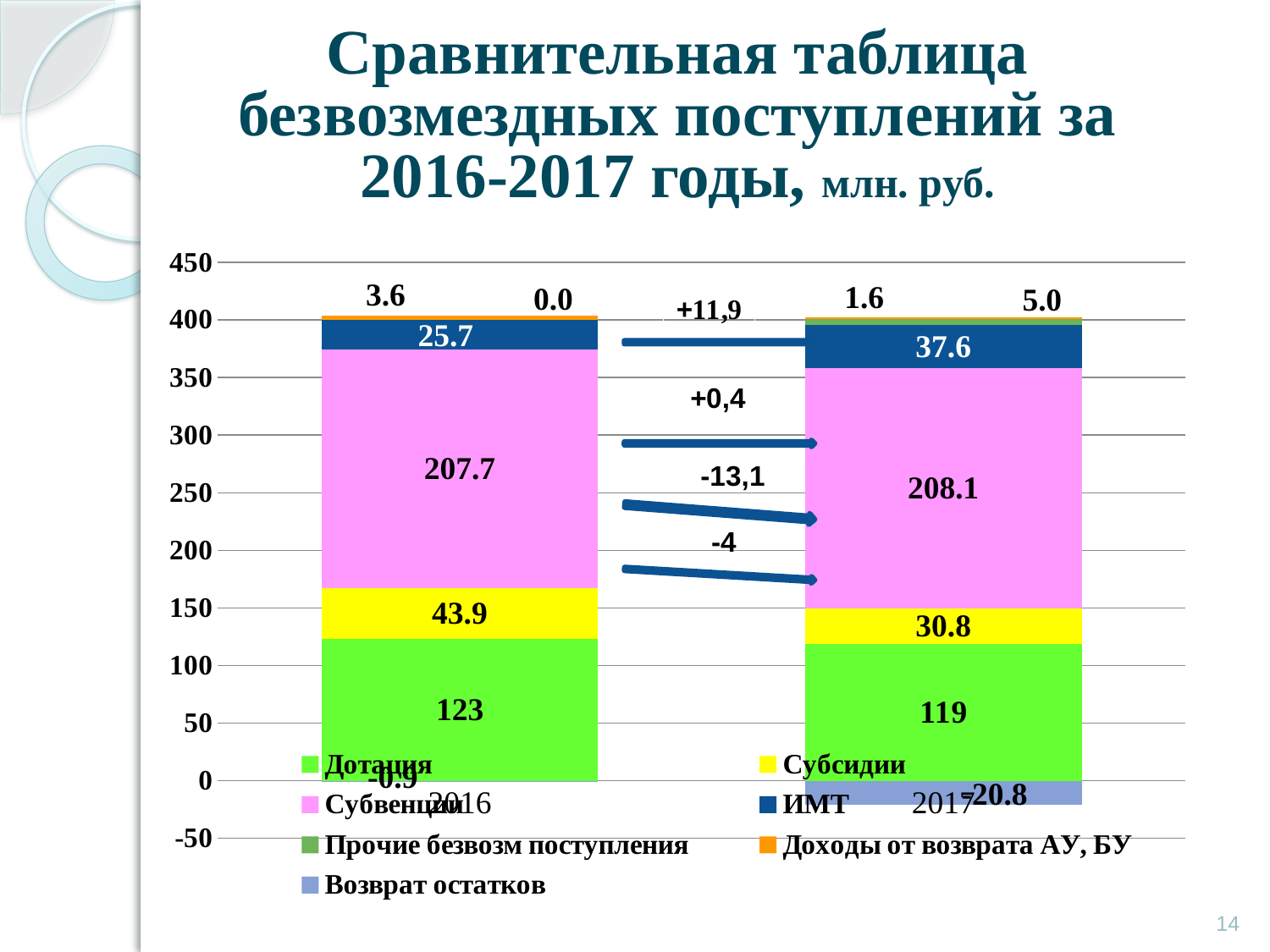
Does the value of Дотация rise or fall from 2016 to 2017? fall What is the value of Дотация for 2016? 123 How many years (categories) are plotted on the x axis? 2 What is the value of Субвенции for 2017? 208.1 What kind of chart is shown on the slide? stacked bar chart In what units are the values on the chart given, according to the title? млн. руб. What is the value of Возврат остатков for 2017? -20.8 How many series does the legend list? 7 What is the value of Субсидии for 2017? 30.8 What is the value of ИМТ for 2016? 25.7 By how much did ИМТ increase from 2016 (25.7) to 2017 (37.6)? 11.9 Which year has the larger value for Субсидии, 2016 or 2017? 2016